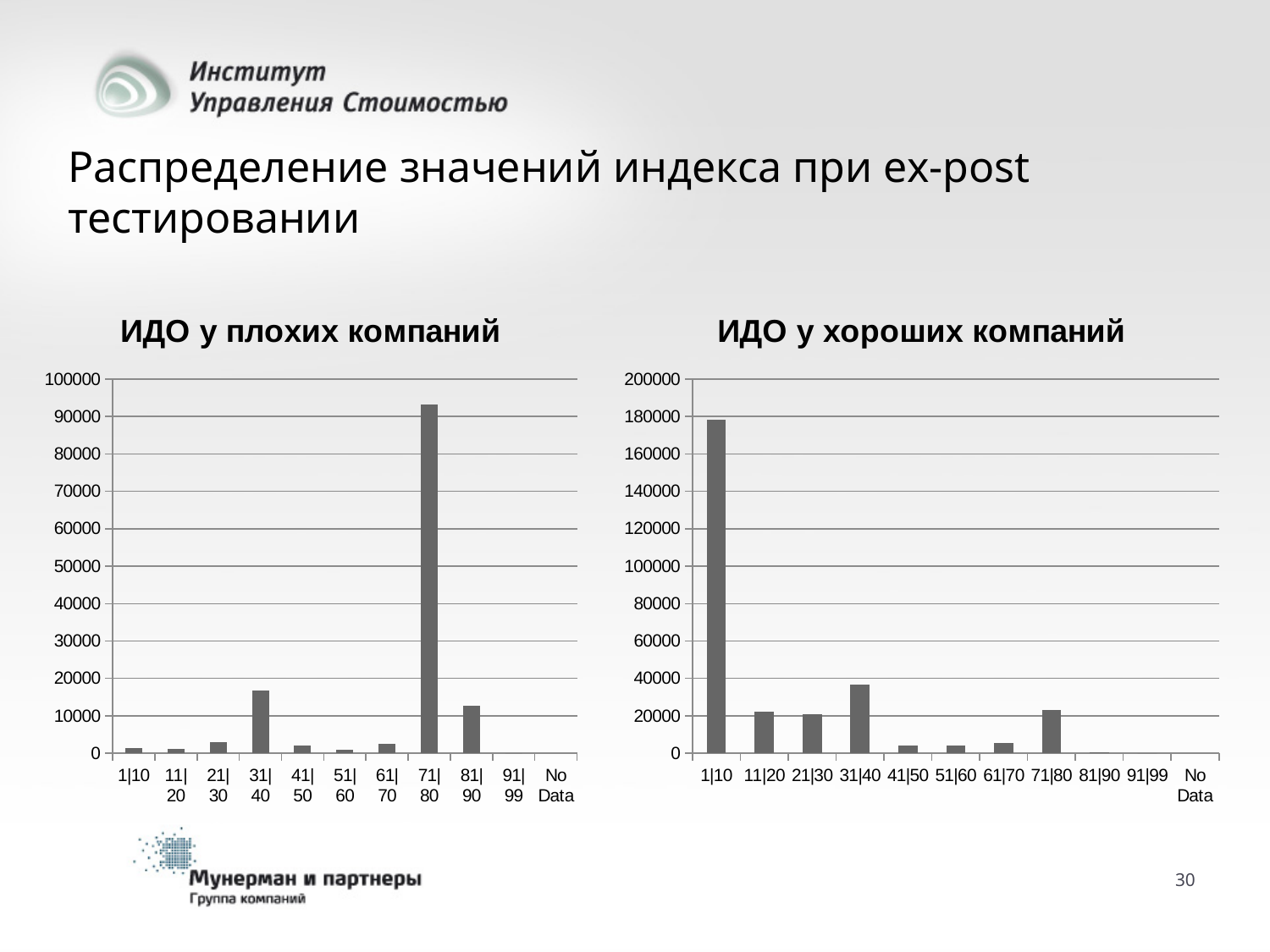
How many categories are shown on the x axis of the 'ИДО у плохих компаний' chart? 11 What type of chart is the 'ИДО у плохих компаний' chart? bar chart In the 'ИДО у хороших компаний' chart, is the value for 11|20 greater or less than 40000? less How many categories are shown on the x axis of the 'ИДО у хороших компаний' chart? 11 In the 'ИДО у хороших компаний' chart, is the value for 1|10 greater or less than 160000? greater In the 'ИДО у плохих компаний' chart, is the value for 71|80 greater or less than 80000? greater In the 'ИДО у хороших компаний' chart, which is larger, the value for 31|40 or the value for 71|80? 31|40 In the 'ИДО у плохих компаний' chart, which is larger, the value for 31|40 or the value for 81|90? 31|40 In the 'ИДО у хороших компаний' chart, which category has the highest value? 1|10 In the 'ИДО у плохих компаний' chart, which category has the highest value? 71|80 What is the title of the chart on the right side of the slide? ИДО у хороших компаний